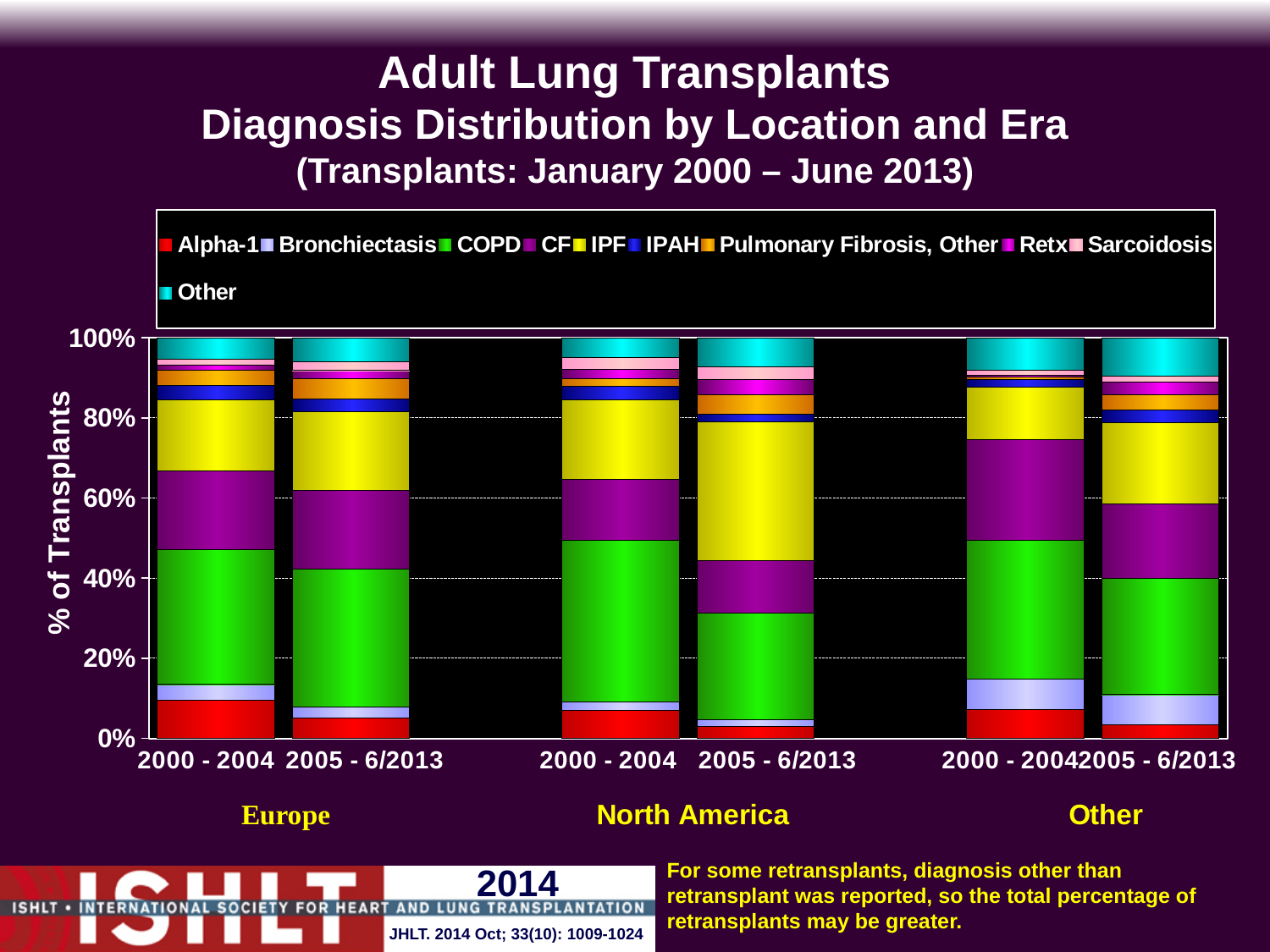
What is the label on the y axis of the chart? % of Transplants Which bar has the larger IPF share: North America 2005 - 6/2013 or Europe 2000 - 2004? North America 2005 - 6/2013 For North America, does the IPF share rise or fall from 2000 - 2004 to 2005 - 6/2013? rise Is the IPF share for North America 2005 - 6/2013 greater or less than 20%? greater How many series does the legend list? 10 How many bars are plotted in the chart? 6 What kind of chart is shown on the slide? Stacked bar chart Is the Alpha-1 share for Europe 2000 - 2004 greater or less than 20%? less Which three locations are shown along the x axis of the chart? Europe, North America, Other Which bar has the larger CF share: Other 2000 - 2004 or North America 2005 - 6/2013? Other 2000 - 2004 Is the CF share for North America 2005 - 6/2013 greater or less than 20%? less